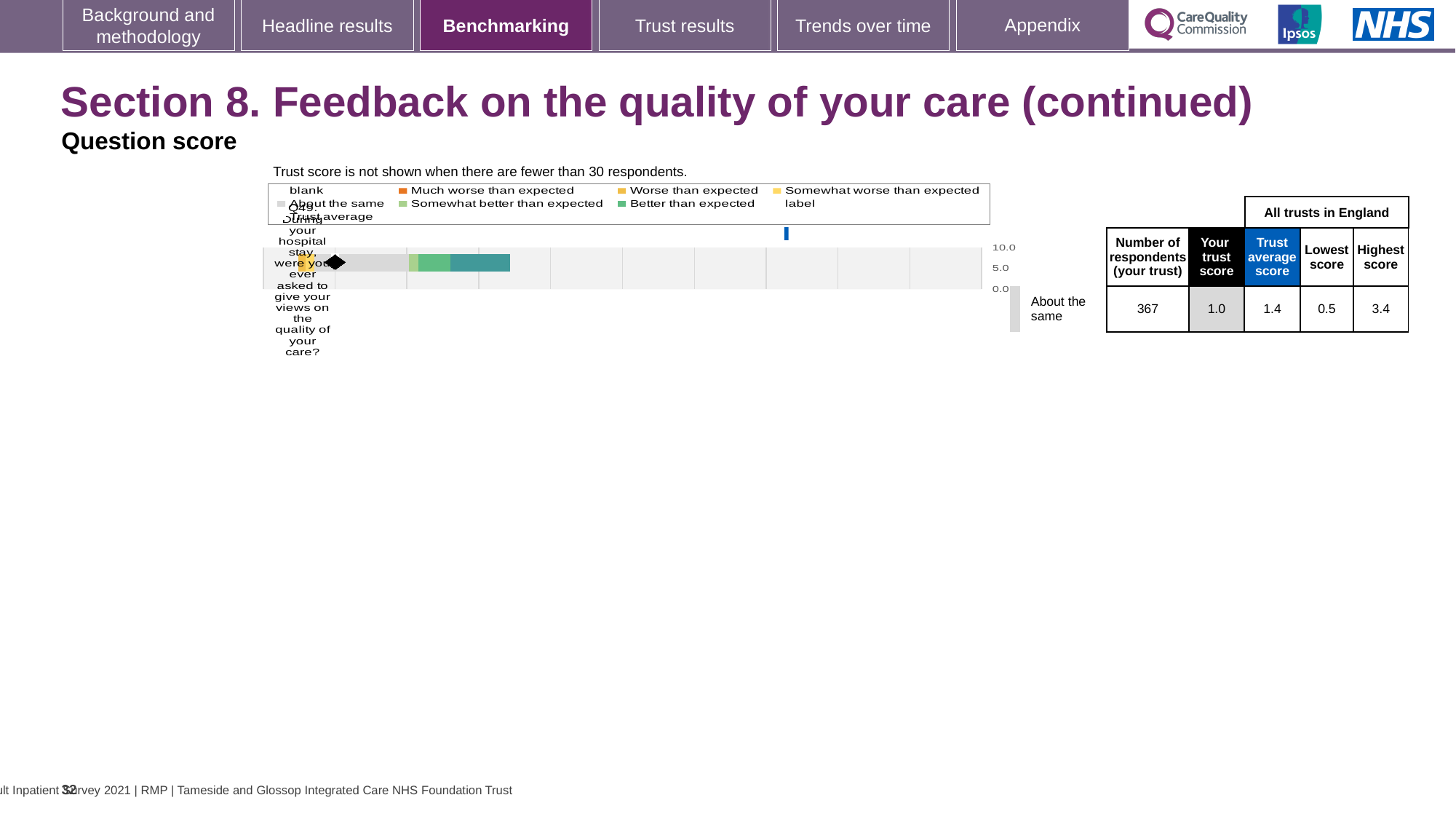
What kind of chart is used to show the Q49 benchmarking result? Bar chart How many respondents from your trust answered Q49? 367 What is the difference between the trust average score and your trust score for Q49? 0.4 Is your trust score for Q49 greater or less than 5.0 on the chart axis? less Which is larger for Q49: your trust score or the trust average score? Trust average score What is the trust score for Q49 shown in the 'Your trust score' column? 1.0 How many questions are plotted on the benchmarking chart? 1 What is the difference between the highest score and the lowest score for Q49 across all trusts in England? 2.9 What is the highest score among all trusts in England for Q49? 3.4 What is the lowest score among all trusts in England for Q49? 0.5 What is the trust average score for Q49 across all trusts in England? 1.4 What benchmarking category is your trust's Q49 score placed in? About the same